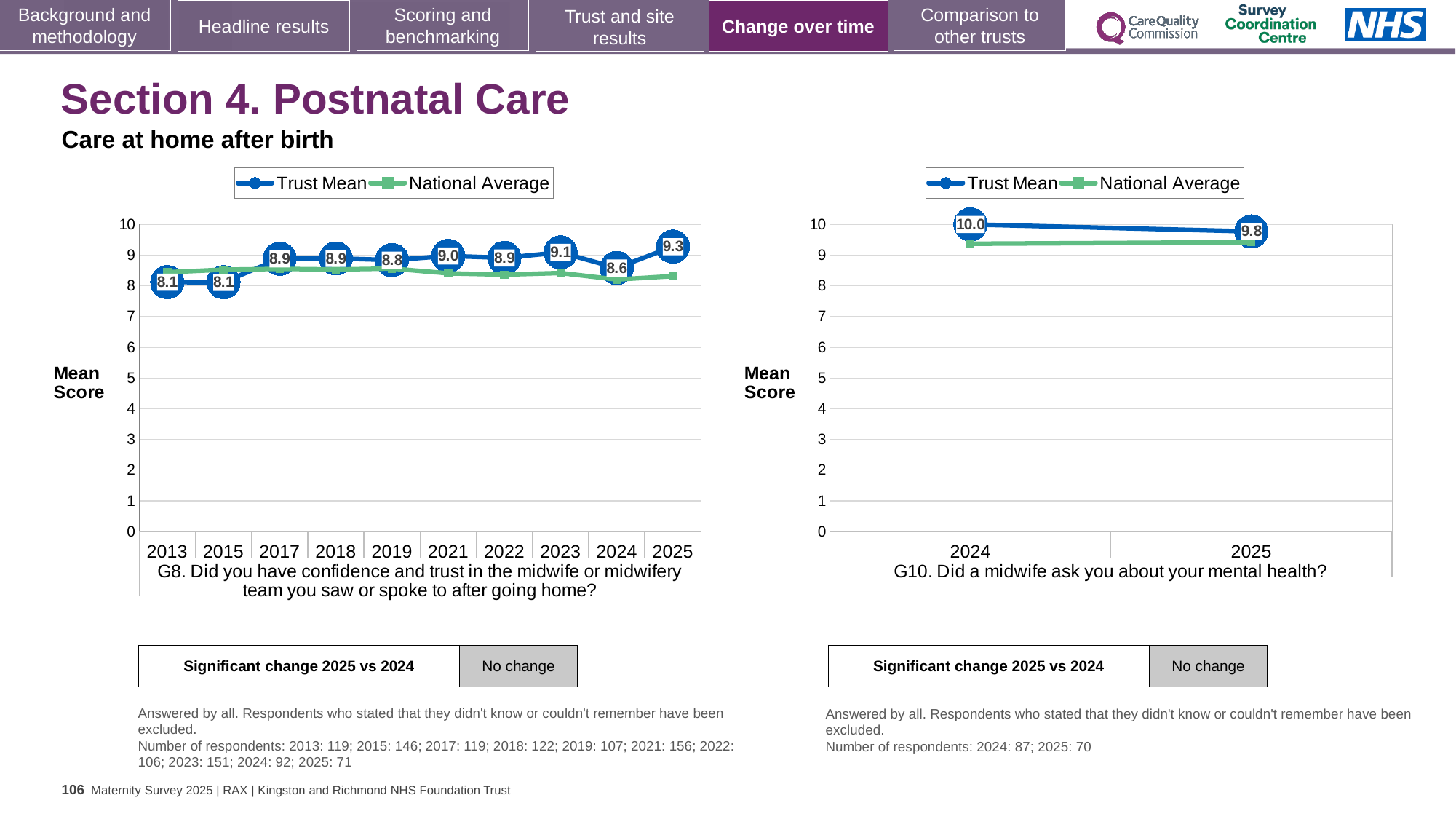
In the G8 chart, which year has the highest Trust Mean score? 2025 In the G8 chart, which is larger: the Trust Mean for 2023 or the Trust Mean for 2019? 2023 In the G10 chart, does the Trust Mean rise or fall from 2024 to 2025? fall How many series does the legend of the G10 chart list? 2 In the G8 chart, what is the Trust Mean score for 2025? 9.3 In the G8 chart, what is the lowest Trust Mean score shown? 8.1 In the G8 chart, what is the Trust Mean score for 2024? 8.6 How many years are plotted on the x axis of the G8 chart? 10 In the G10 chart, what is the difference between the Trust Mean scores for 2024 and 2025? 0.2 In the G10 chart, what is the Trust Mean score for 2024? 10.0 In the G8 chart, is the National Average value for 2025 greater or less than 9? less In the G8 chart, what is the difference between the Trust Mean scores for 2025 and 2024? 0.7